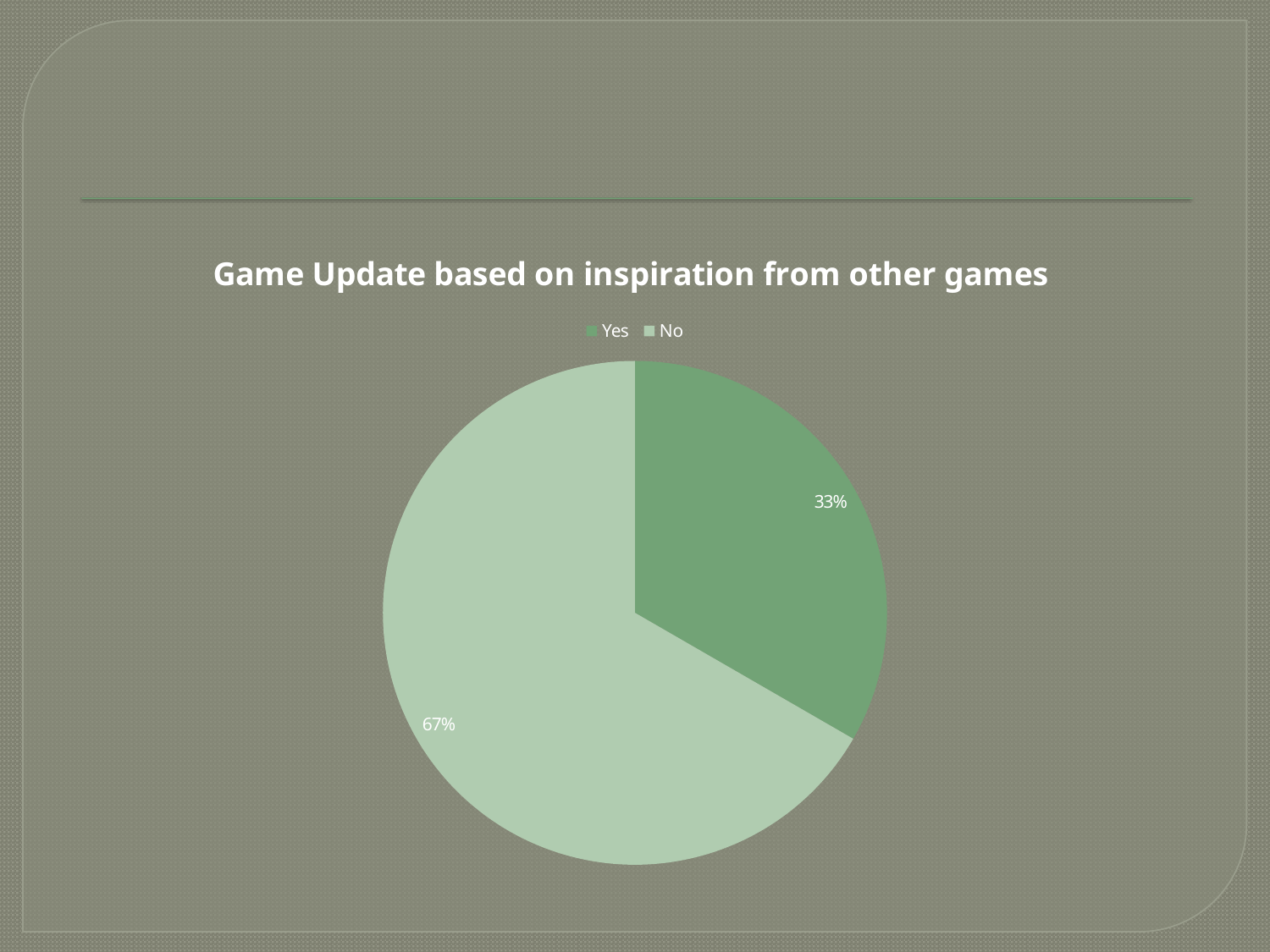
What is the title of the chart? Game Update based on inspiration from other games How many entries does the legend list? 2 What share of the pie does the "Yes" slice represent? 33% What is the difference in percentage points between the "No" slice and the "Yes" slice? 34 percentage points What share of the pie does the "No" slice represent? 67% Which category has the largest slice of the pie? No Which is larger, the "Yes" slice or the "No" slice? No Which category has the smallest slice of the pie? Yes How many slices does the pie chart have? 2 What kind of chart is shown on the slide? pie chart What are the two categories listed in the legend? Yes and No